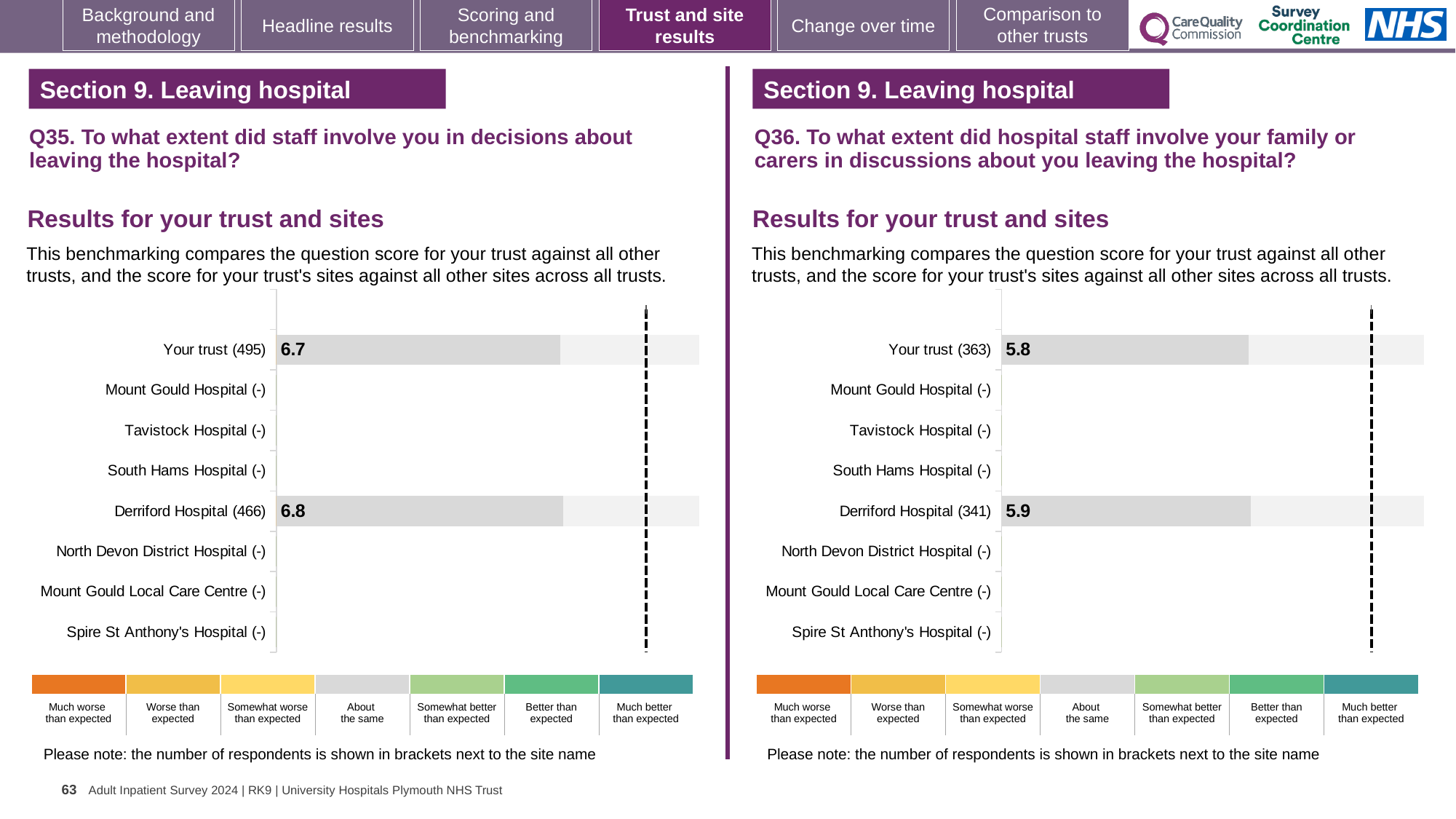
In the Q35 chart on the left, what is the difference between the Derriford Hospital score and the Your trust score? 0.1 In the Q35 chart on the left, what is the score for Derriford Hospital? 6.8 In the Q35 chart on the left, what is the score for Your trust? 6.7 In the Q36 chart on the right, what is the score for Your trust? 5.8 In the Q35 chart on the left, how many respondents are shown in brackets for Your trust? 495 Is the Your trust score in the Q35 chart on the left higher or lower than the Your trust score in the Q36 chart on the right? Higher In the Q36 chart on the right, how many respondents are shown in brackets for Derriford Hospital? 341 How many site or trust categories are listed on the y axis of the Q35 chart on the left? 8 What kind of chart is the Q36 chart on the right? Bar chart In the Q36 chart on the right, what is the score for Derriford Hospital? 5.9 In the Q36 chart on the right, what is the difference between the Derriford Hospital score and the Your trust score? 0.1 How many benchmark categories are shown in the colour legend below the Q35 chart on the left? 7